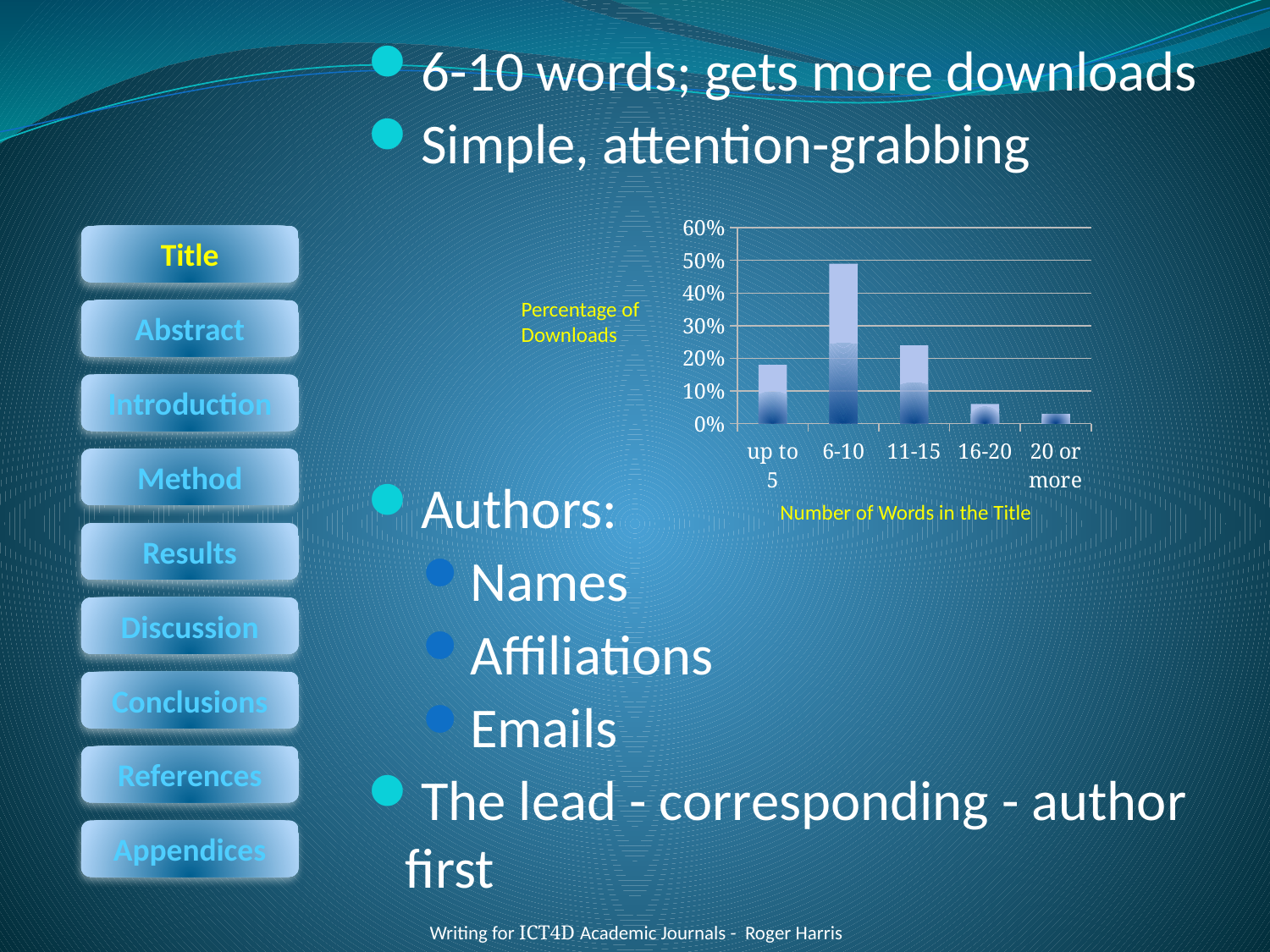
What is the label on the x axis of the chart? Number of Words in the Title Which title length category has the lowest percentage of downloads? 20 or more Which has a higher percentage of downloads, 'up to 5' words or '11-15' words? 11-15 Is the value for '16-20' words greater or less than 10%? less Is the value for 'up to 5' words greater or less than 20%? less How many categories are shown on the x axis of the chart? 5 Is the value for '6-10' words greater or less than 40%? greater Do the values rise or fall along the x axis from '6-10' words to '20 or more' words? fall Which title length category has the highest percentage of downloads? 6-10 What kind of chart is shown on the slide? bar chart Which has a higher percentage of downloads, '16-20' words or '20 or more' words? 16-20